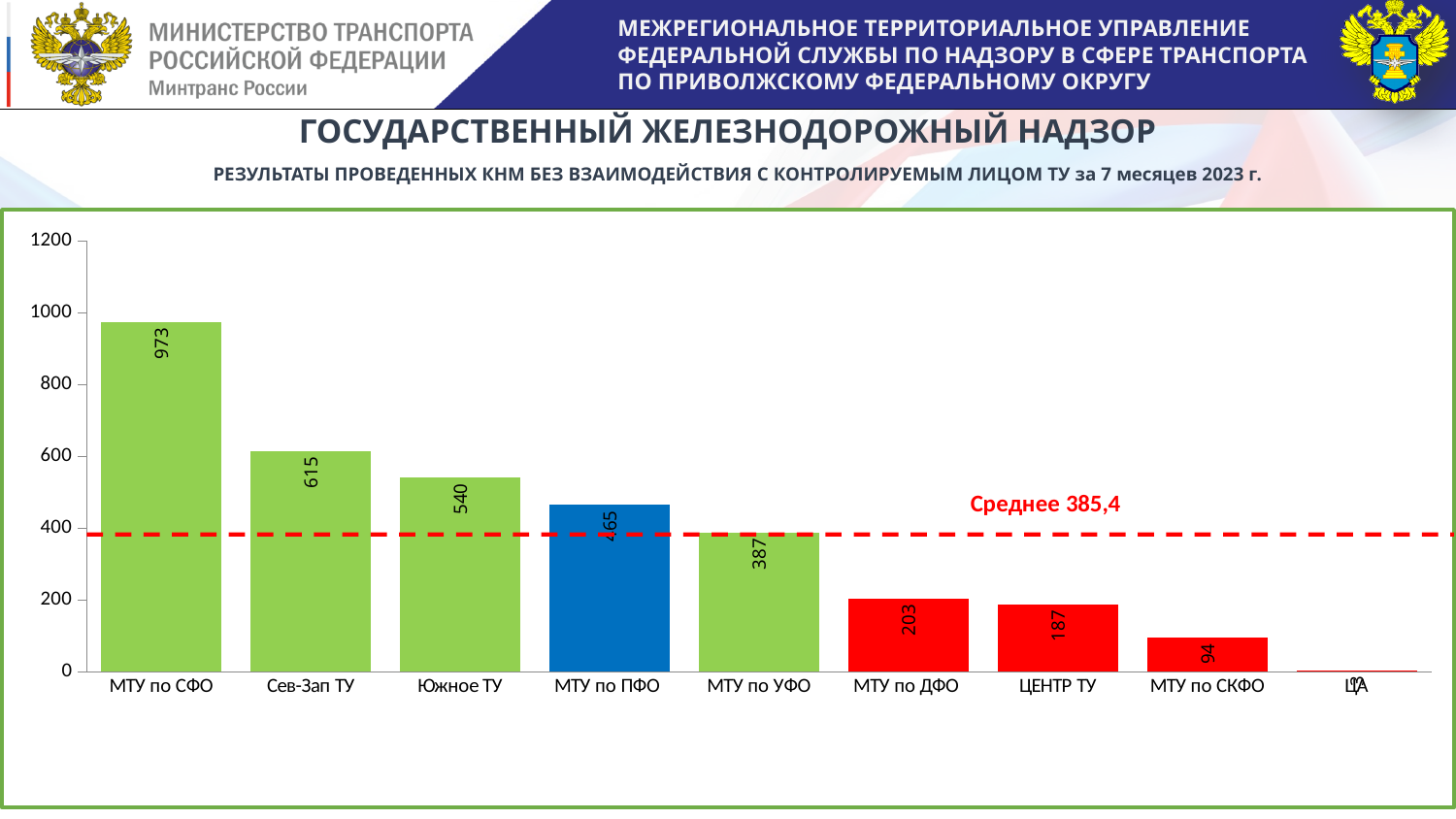
What is the value for МТУ по СФО? 973 What kind of chart is shown on the slide? bar chart What average value is indicated by the red dashed line? 385,4 Which category has the highest value? МТУ по СФО Which bar is coloured blue? МТУ по ПФО Which is larger, the value for МТУ по ДФО or the value for ЦЕНТР ТУ? МТУ по ДФО What is the value for МТУ по ПФО? 465 How many categories are shown on the x axis? 9 What is the value for МТУ по СКФО? 94 Is the value for МТУ по УФО greater or less than 400? less What is the value for Сев-Зап ТУ? 615 What is the difference between the values for Сев-Зап ТУ and Южное ТУ? 75